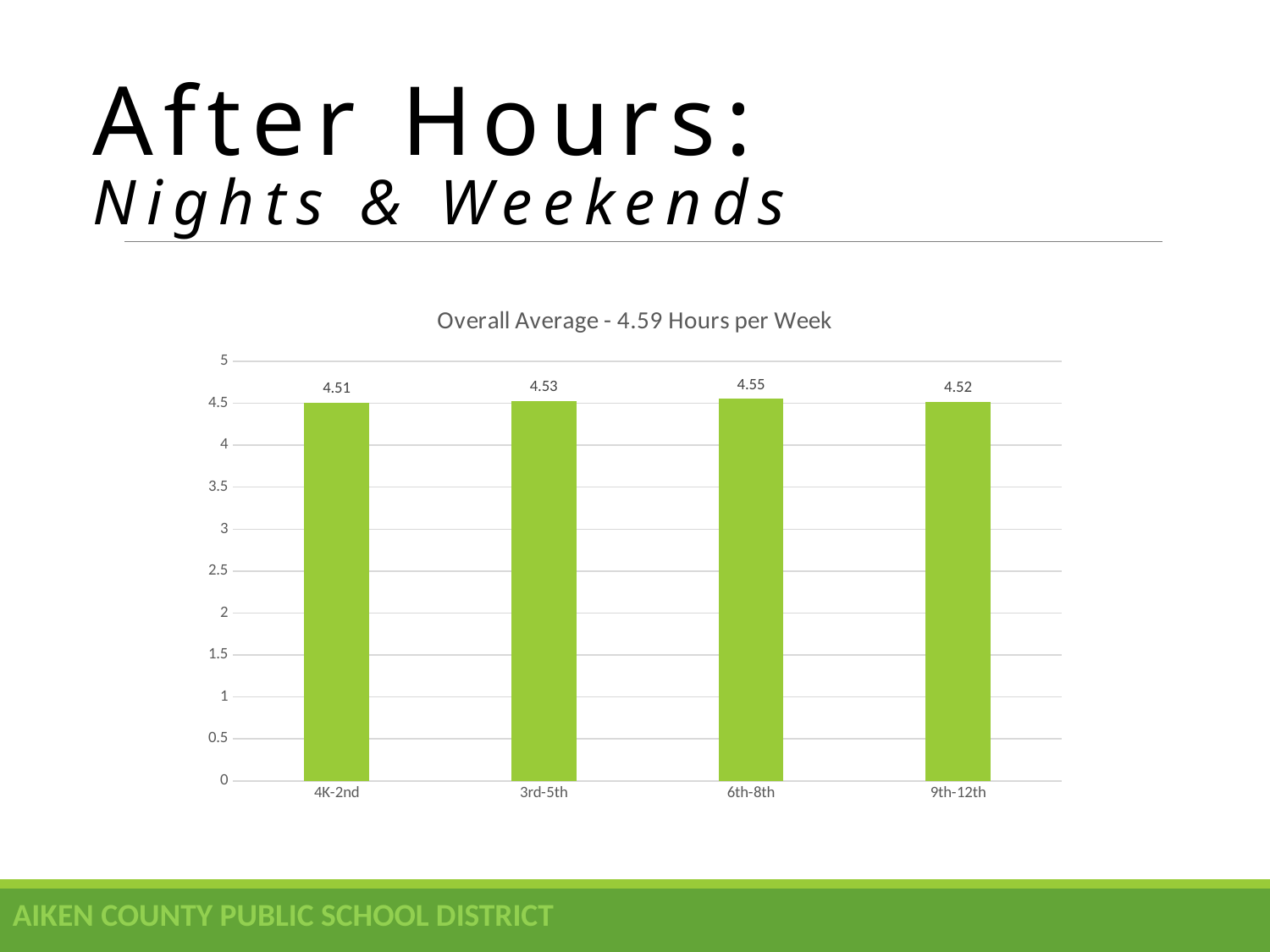
What is the value for 9th-12th? 4.52 What is the title of the chart? Overall Average - 4.59 Hours per Week What is the value for 3rd-5th? 4.53 What kind of chart is shown on the slide? bar chart What is the difference between the values for 6th-8th and 4K-2nd? 0.04 Is the value for 9th-12th greater or less than 4? greater What is the value for 4K-2nd? 4.51 Which grade band has the highest value? 6th-8th Which is larger, the value for 3rd-5th or the value for 9th-12th? 3rd-5th What is the value for 6th-8th? 4.55 Which grade band has the lowest value? 4K-2nd How many grade bands are shown on the x axis? 4